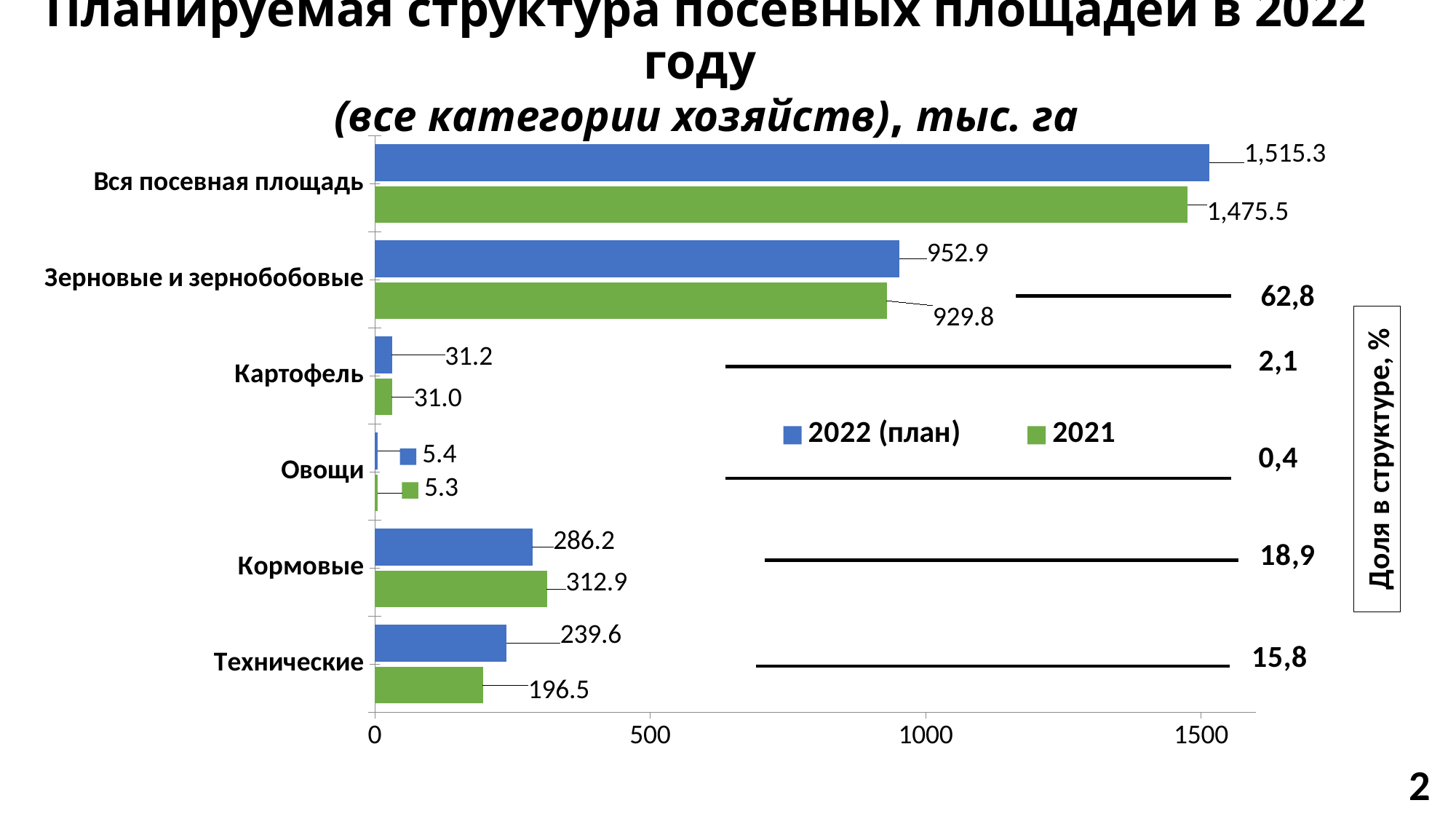
Which category has the lowest 2022 (план) value? Овощи What is the 2022 (план) value for Технические? 239.6 What is the difference between the 2022 (план) and 2021 values for Технические? 43.1 What is the 2021 value for Кормовые? 312.9 What is the 2022 (план) value for Вся посевная площадь? 1,515.3 Excluding Вся посевная площадь, which category has the highest 2021 value? Зерновые и зернобобовые What kind of chart is shown on the slide? Bar chart How many series does the legend list? 2 How many categories are shown on the chart? 6 What is the 2021 value for Зерновые и зернобобовые? 929.8 For Кормовые, which is larger: the 2022 (план) value or the 2021 value? 2021 What share in the structure (Доля в структуре, %) is shown for Зерновые и зернобобовые? 62,8